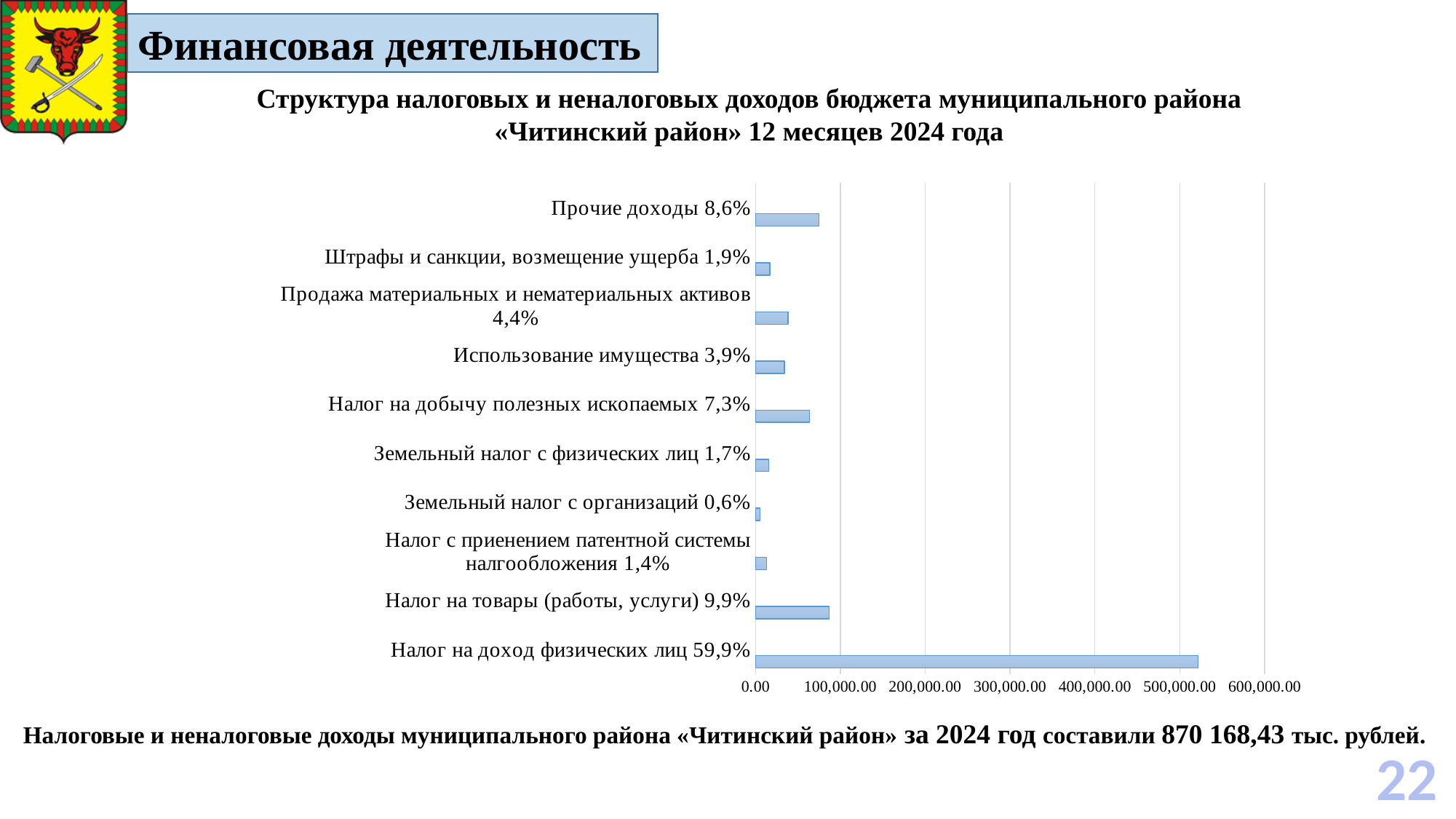
Which is larger: the value for «Прочие доходы» or the value for «Штрафы и санкции, возмещение ущерба»? Прочие доходы Is the value for «Налог на доход физических лиц» greater or less than 500,000.00? greater How many categories are plotted in the chart? 10 What share is shown in the label for «Использование имущества»? 3,9% What kind of chart is shown on the slide? Bar chart By how many percentage points does the share of «Налог на товары (работы, услуги)» exceed the share of «Прочие доходы», according to the labels? 1,3 What is the title of the chart? Структура налоговых и неналоговых доходов бюджета муниципального района «Читинский район» 12 месяцев 2024 года What share is shown in the label for «Налог на добычу полезных ископаемых»? 7,3% Which category has the highest value in the chart? Налог на доход физических лиц Is the value for «Налог на товары (работы, услуги)» greater or less than 100,000.00? less What share is shown in the label for «Налог на доход физических лиц»? 59,9% Which category has the lowest value in the chart? Земельный налог с организаций